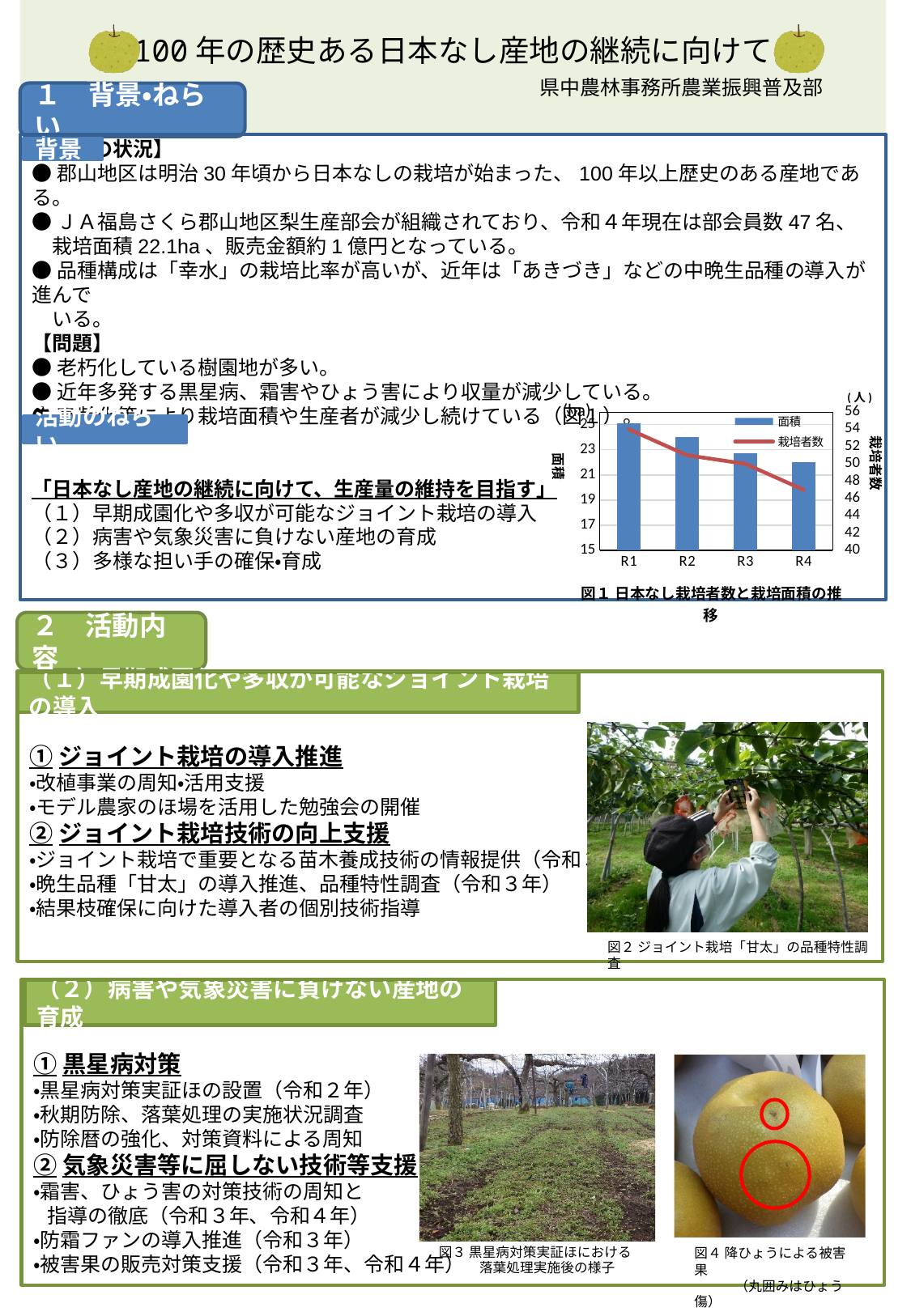
In 図1, is the 面積 value for R4 greater or less than 23? less In 図1, which series is drawn as bars? 面積 What are the two legend entries in 図1? 面積 and 栽培者数 In 図1, which year has the highest 面積 bar? R1 In 図1, is the 面積 value for R1 greater or less than 23? greater How many years (categories) are shown on the x axis of 図1? 4 In 図1, which is larger, the 面積 for R1 or for R4? R1 How many series does the legend of 図1 list? 2 What kind of chart is 図1 (日本なし栽培者数と栽培面積の推移)? A combined bar and line chart In 図1, does the 栽培者数 line rise or fall from R1 to R4? Fall In 図1, which year has the lowest 面積 bar? R4 In 図1, is the 栽培者数 value for R1 greater or less than 52? greater